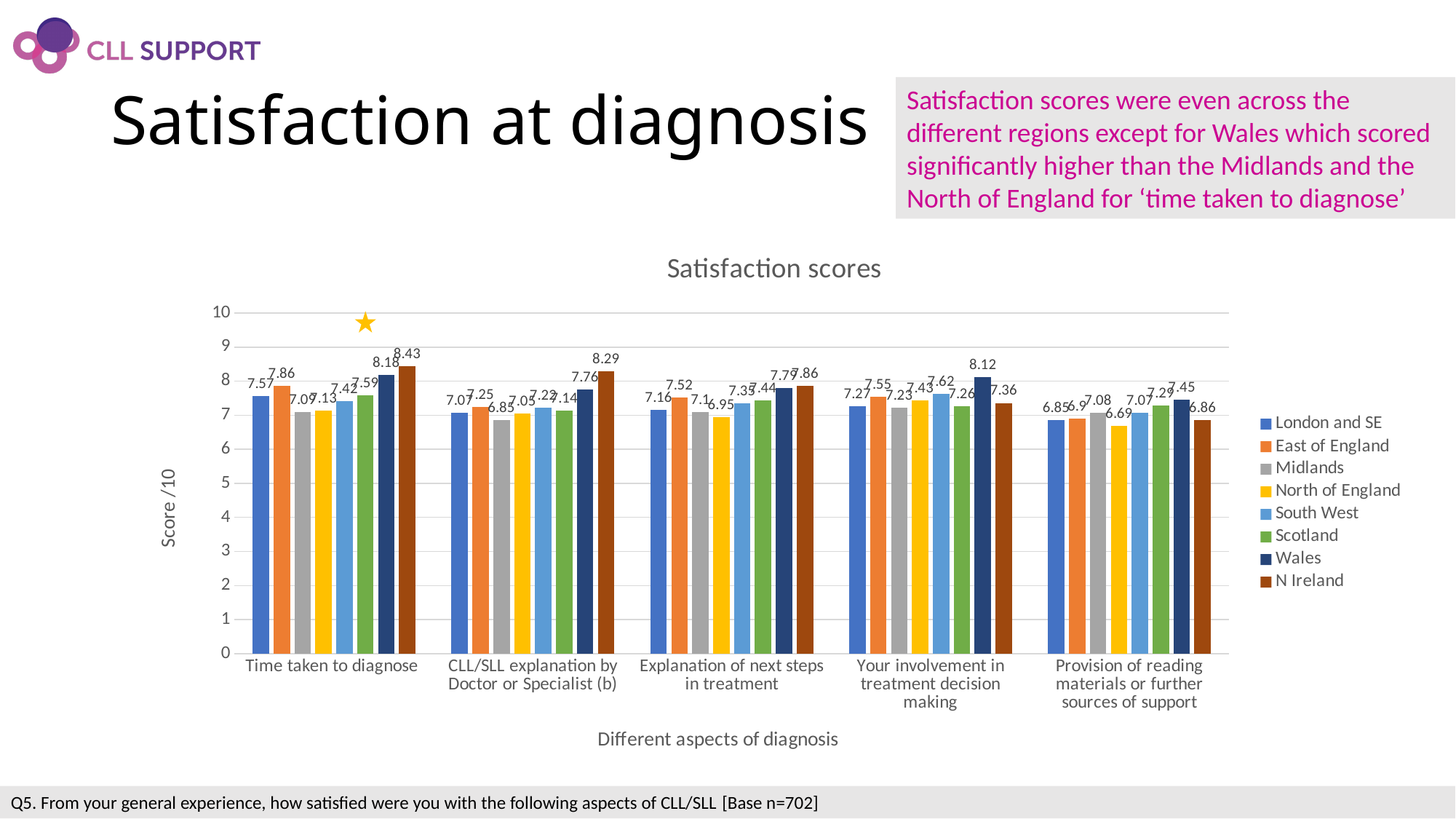
What is the label on the vertical axis of the chart? Score /10 What is the satisfaction score for Wales for 'Your involvement in treatment decision making'? 8.12 Which region has the highest score for 'Time taken to diagnose'? N Ireland What is the satisfaction score for N Ireland for 'Time taken to diagnose'? 8.43 What kind of chart is shown on the slide? Bar chart For 'Explanation of next steps in treatment', which scored higher: East of England or London and SE? East of England What is the difference between the Wales and Midlands scores for 'CLL/SLL explanation by Doctor or Specialist (b)'? 0.91 Which region has the highest score for 'CLL/SLL explanation by Doctor or Specialist (b)'? N Ireland Is the Wales score for 'Time taken to diagnose' greater or less than 8? greater Which region has the lowest score for 'Provision of reading materials or further sources of support'? North of England How many regions does the legend list? 8 How many aspects of diagnosis are shown on the x axis? 5